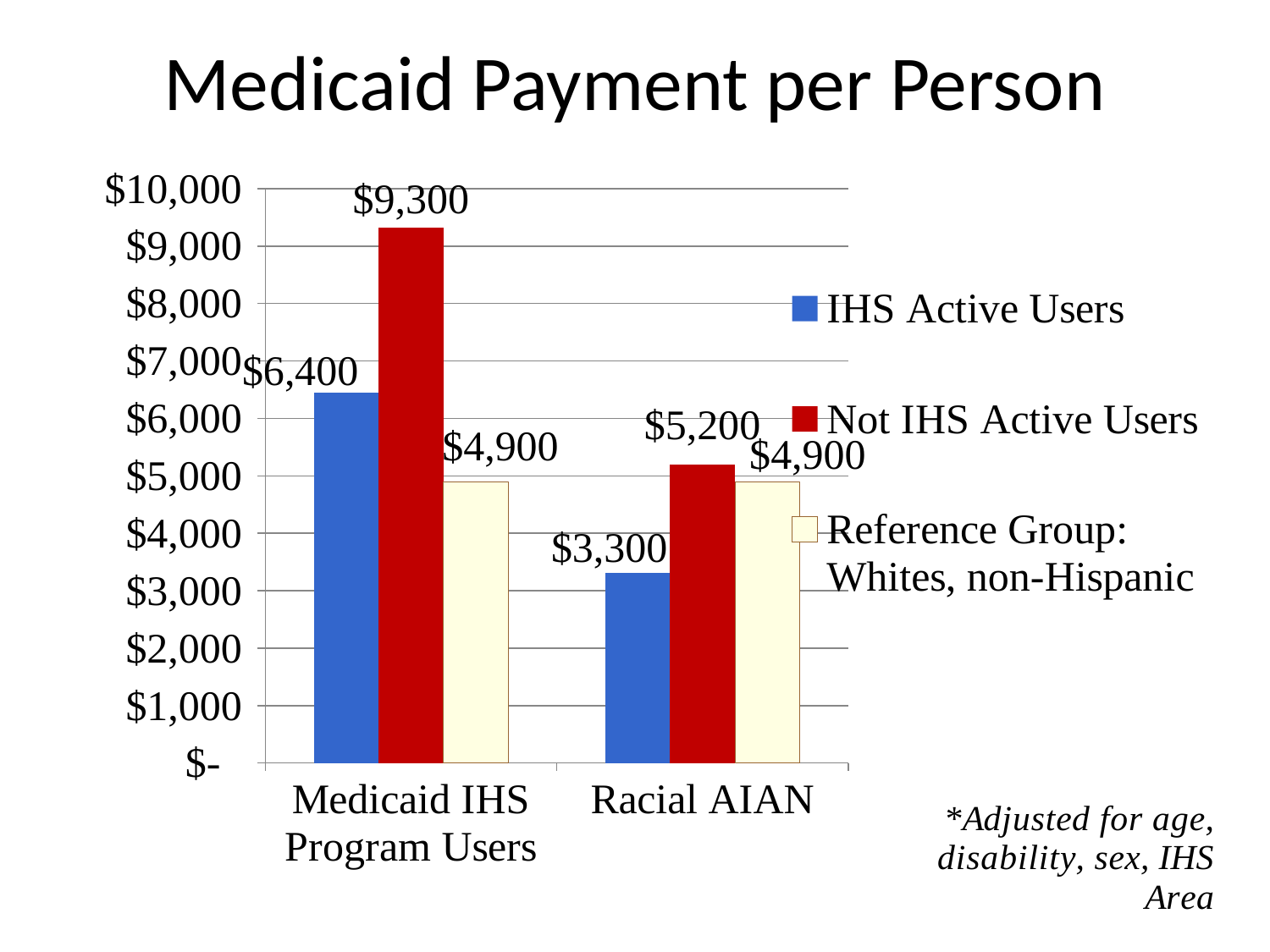
What is the value for Not IHS Active Users in the Racial AIAN group? $5,200 What is the title of the chart? Medicaid Payment per Person What kind of chart is shown on the slide? Bar chart How many categories are shown on the x axis? 2 What is the value for the Reference Group: Whites, non-Hispanic in the Medicaid IHS Program Users group? $4,900 What is the difference between the Reference Group and IHS Active Users in the Racial AIAN group? $1,600 How many series does the legend list? 3 What is the Medicaid payment per person for IHS Active Users in the Medicaid IHS Program Users group? $6,400 Which series has the lowest value in the Racial AIAN group? IHS Active Users Which series has the highest value in the Medicaid IHS Program Users group? Not IHS Active Users What is the difference between Not IHS Active Users and IHS Active Users in the Medicaid IHS Program Users group? $2,900 Which is larger: IHS Active Users in the Medicaid IHS Program Users group or Not IHS Active Users in the Racial AIAN group? IHS Active Users in the Medicaid IHS Program Users group